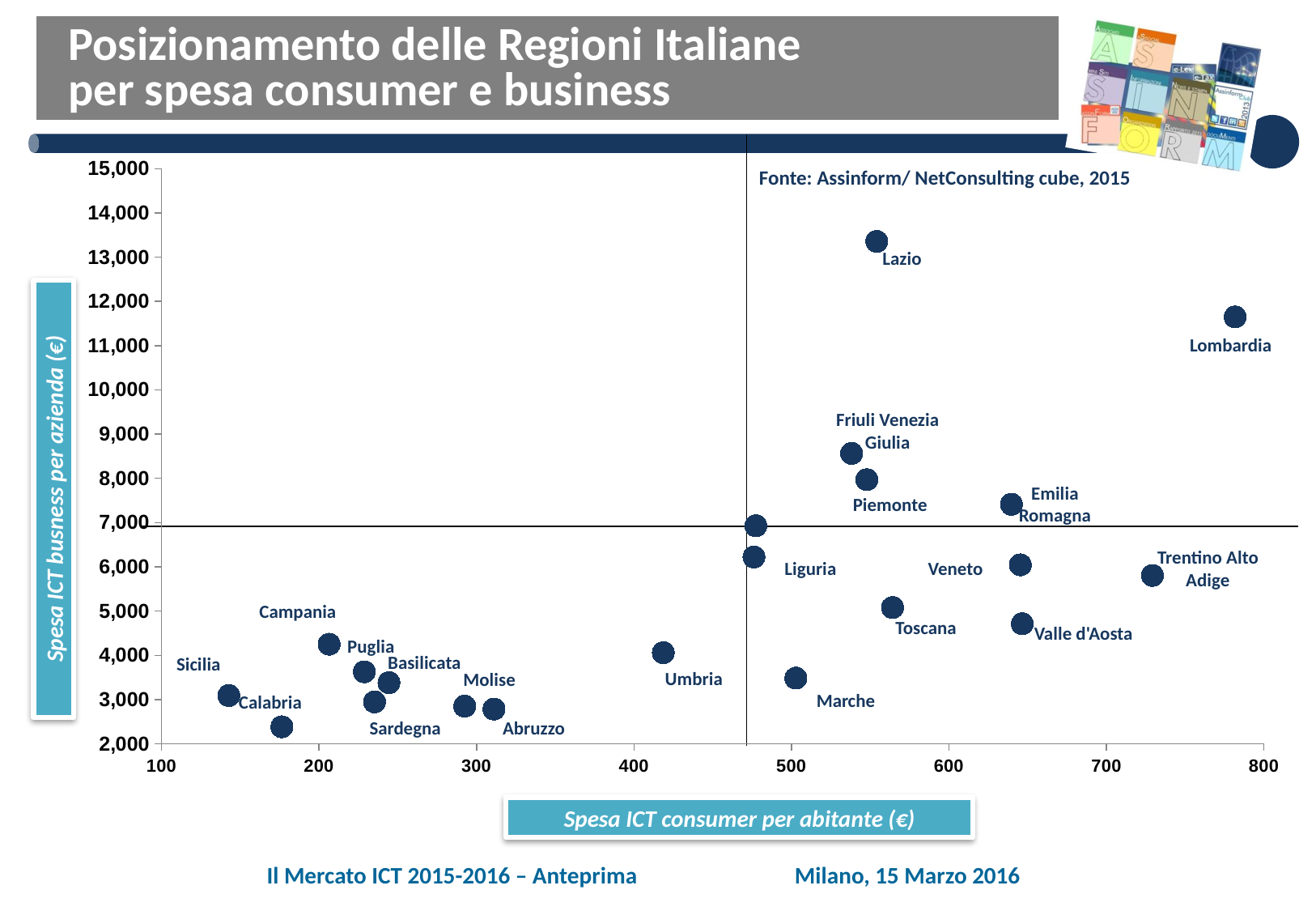
Which region has the highest Spesa ICT consumer per abitante? Lombardia What is the label of the horizontal axis? Spesa ICT consumer per abitante (€) What kind of chart is shown on the slide? scatter chart Is the Spesa ICT business per azienda for Marche greater or less than 4,000? less Which region has the higher Spesa ICT business per azienda, Lazio or Lombardia? Lazio Which region has the higher Spesa ICT business per azienda, Umbria or Marche? Umbria Which region has the lowest Spesa ICT consumer per abitante? Sicilia Is the Spesa ICT business per azienda for Lazio greater or less than 13,000? greater Is the Spesa ICT consumer per abitante for Umbria greater or less than 400? greater Which region has the lowest Spesa ICT business per azienda? Calabria Which region has the highest Spesa ICT business per azienda? Lazio